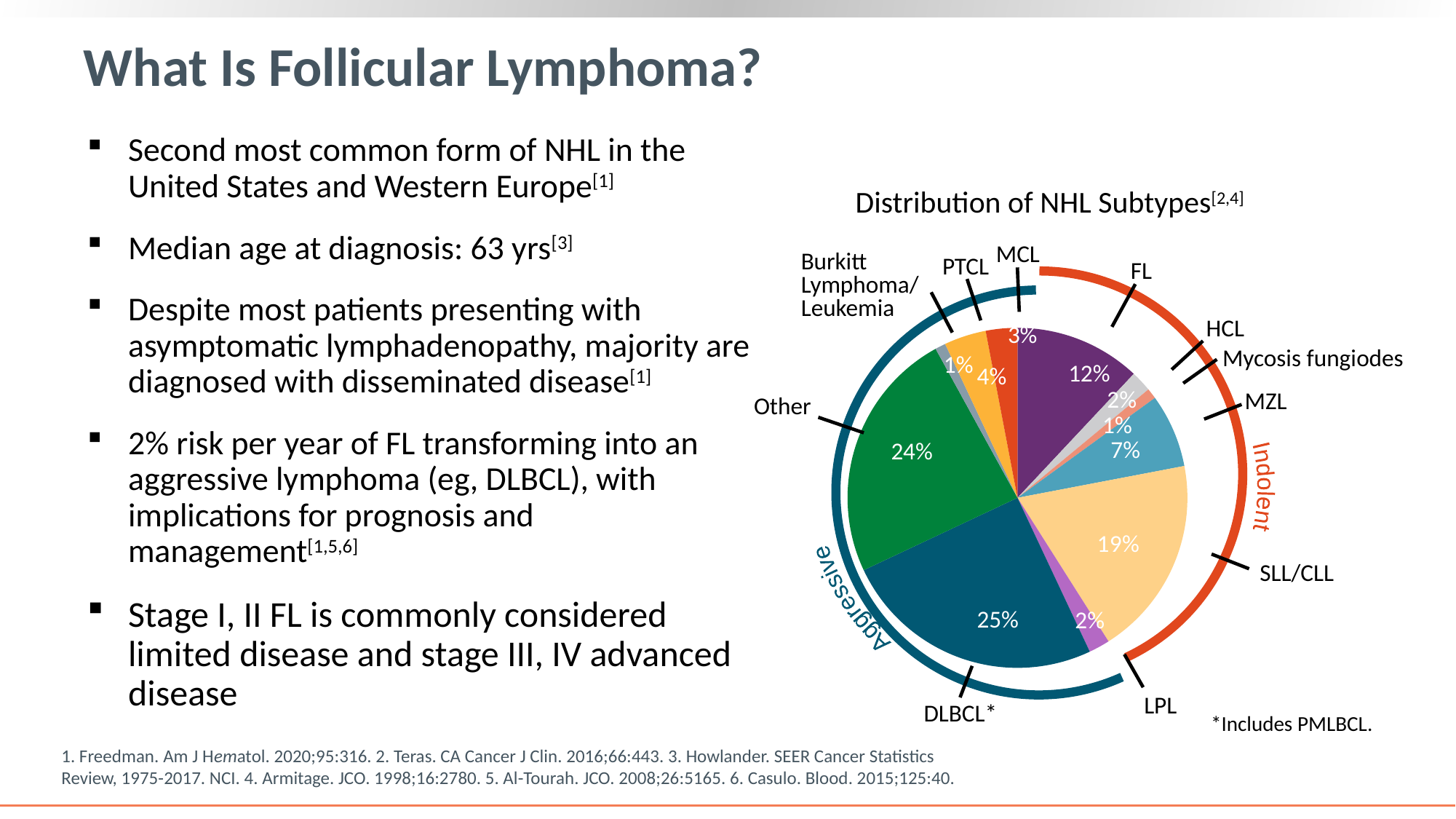
What percentage is shown for DLBCL in the pie chart? 25% What share of NHL subtypes does FL account for in the pie chart? 12% Which NHL subtype has the largest slice in the pie chart? DLBCL Which is larger in the pie chart, FL or MZL? FL What percentage is shown for SLL/CLL in the pie chart? 19% What kind of chart is shown on the slide? Pie chart How many NHL subtype slices are labeled in the pie chart? 11 What is the difference in percentage points between FL and MZL in the pie chart? 5 What is the title of the chart? Distribution of NHL Subtypes What percentage is shown for MCL in the pie chart? 3% What percentage is shown for MZL in the pie chart? 7% What percentage is shown for PTCL in the pie chart? 4%